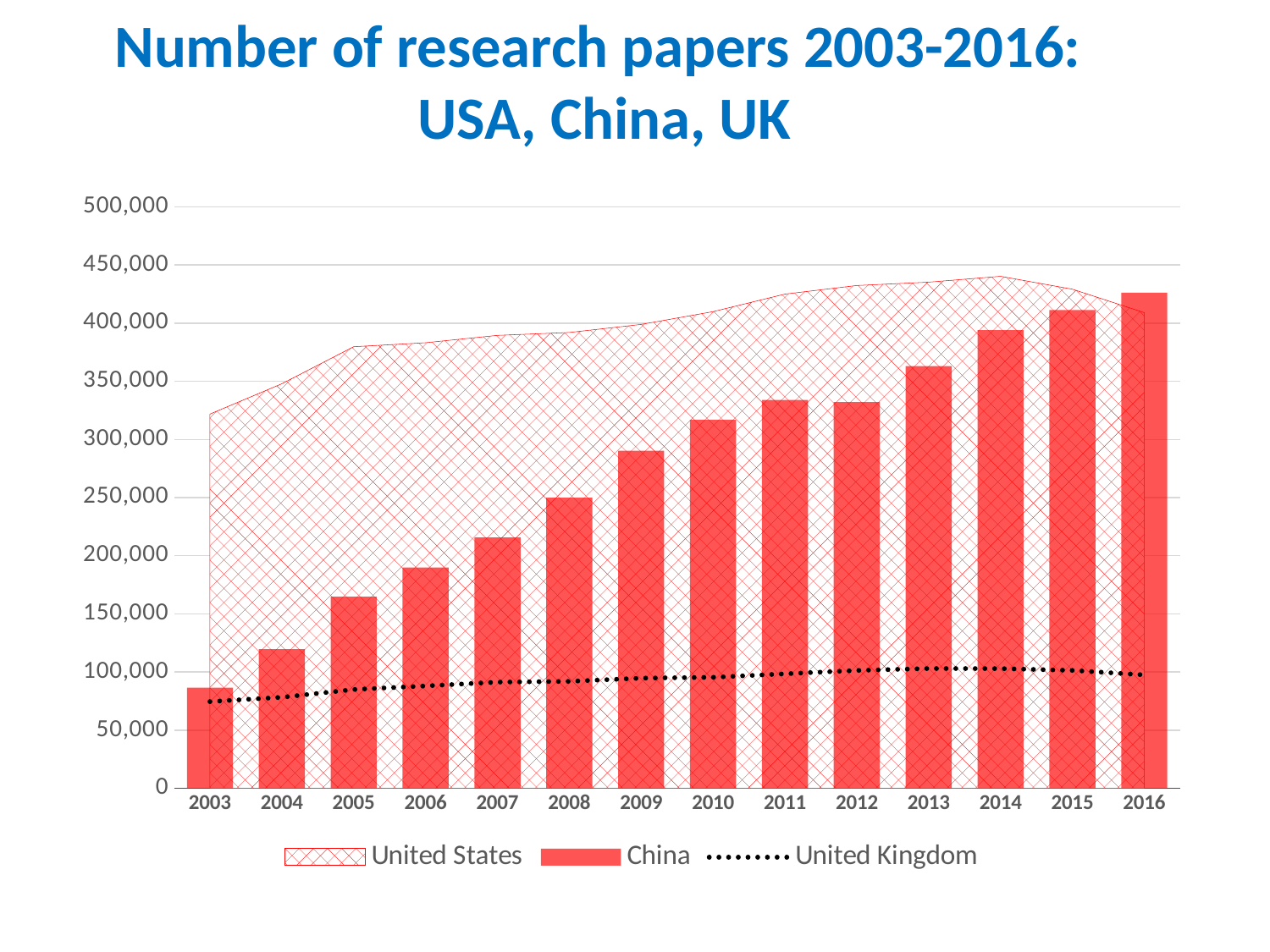
In which year is the China value highest? 2016 How many years are shown on the x axis? 14 Is the value for the United Kingdom in 2003 greater or less than 100,000? less In which year is the China value lowest? 2003 What kind of chart is used to plot the China series? bar chart Is the value for China in 2008 greater or less than 300,000? less Is the value for China in 2016 greater or less than 400,000? greater Do the China values rise or fall from 2003 to 2016? rise How many series does the legend list? 3 What are the three series named in the legend? United States, China, United Kingdom